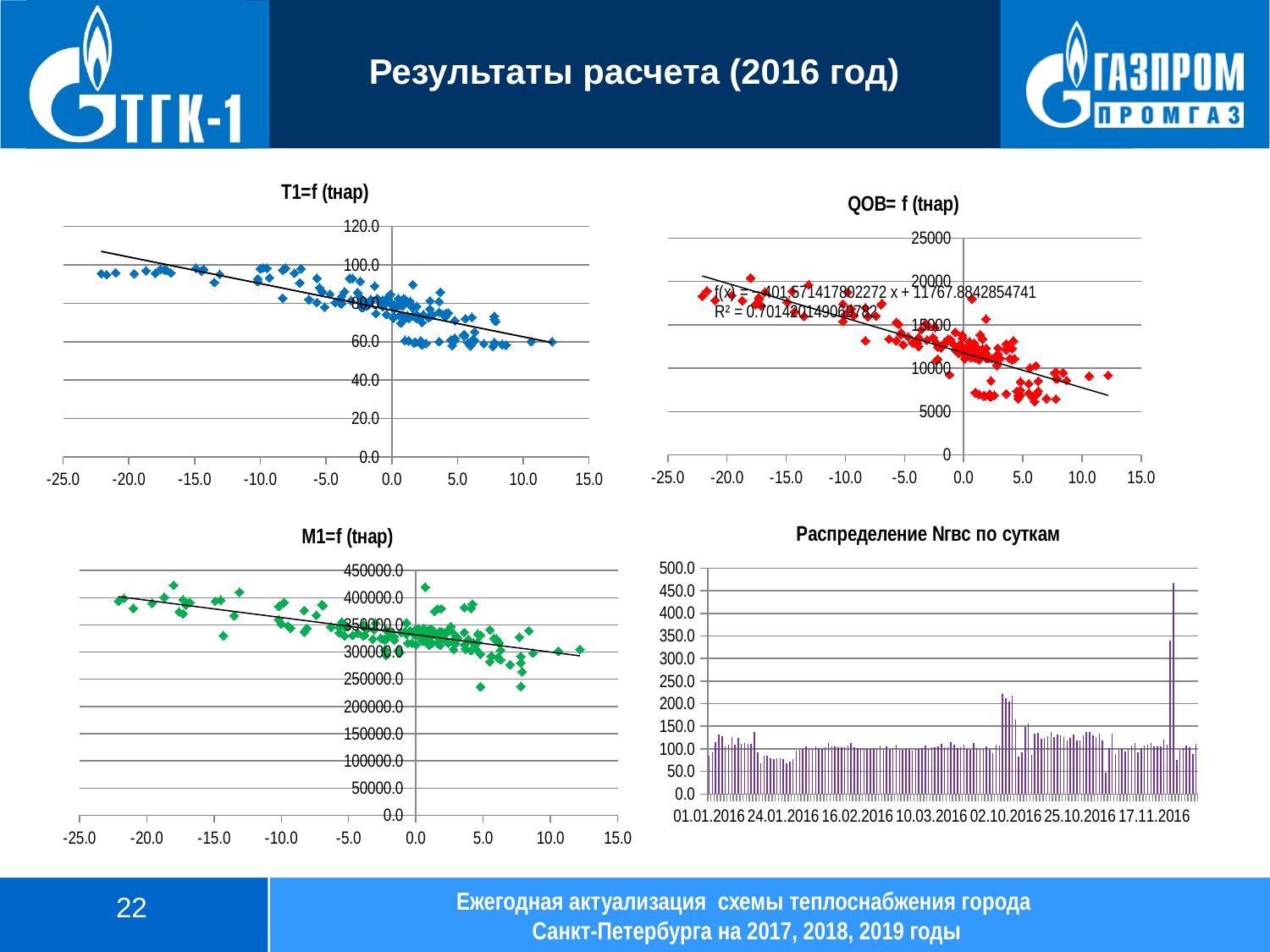
In the chart "M1=f (тнар)", do the values rise or fall as the x-axis value increases? fall What is the first date label on the x-axis of the chart "Распределение Nгвс по суткам"? 01.01.2016 In the chart "Распределение Nгвс по суткам", is the tallest bar greater or less than 400.0? greater In the chart "QOB= f (тнар)", do the values rise or fall as the x-axis value increases? fall How many charts are shown on the slide? 4 What colour are the data points in the chart "QOB= f (тнар)"? red What kind of chart is "T1=f (тнар)"? scatter chart In the chart "QOB= f (тнар)", are the points at x = 10.0 greater or less than 15000? less In the chart "Распределение Nгвс по суткам", is the value of the first bar (01.01.2016) greater or less than 150.0? less In the chart "T1=f (тнар)", do the values rise or fall as the x-axis value increases? fall What kind of chart is "Распределение Nгвс по суткам"? bar chart